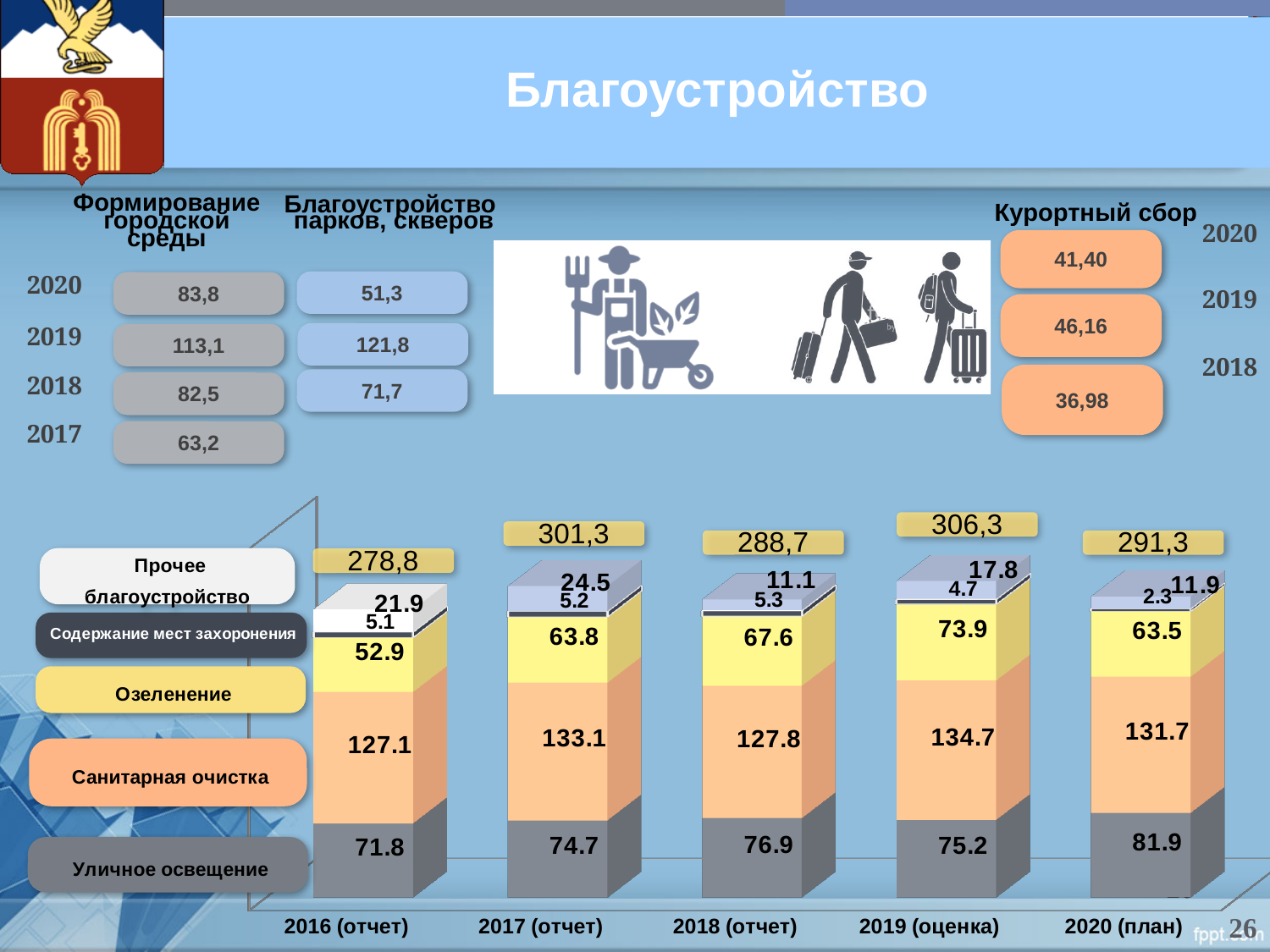
What is the total of the stacked bar for 2019 (оценка)? 306,3 What is the difference between Уличное освещение in 2020 (план) and in 2016 (отчет)? 10.1 What is the value for Озеленение in 2016 (отчет)? 52.9 Which year has the highest total shown above its bar? 2019 (оценка) Which is larger: Прочее благоустройство in 2017 (отчет) or in 2018 (отчет)? 2017 (отчет) What is the value for Санитарная очистка in 2019 (оценка)? 134.7 How many years (categories) are shown on the x axis of the stacked bar chart? 5 What kind of chart is shown at the bottom of the slide? Stacked bar chart How many series does the stacked bar chart's legend list? 5 Which year has the lowest total shown above its bar? 2016 (отчет) What is the value for Содержание мест захоронения in 2018 (отчет)? 5.3 What is the value for Уличное освещение in 2020 (план)? 81.9